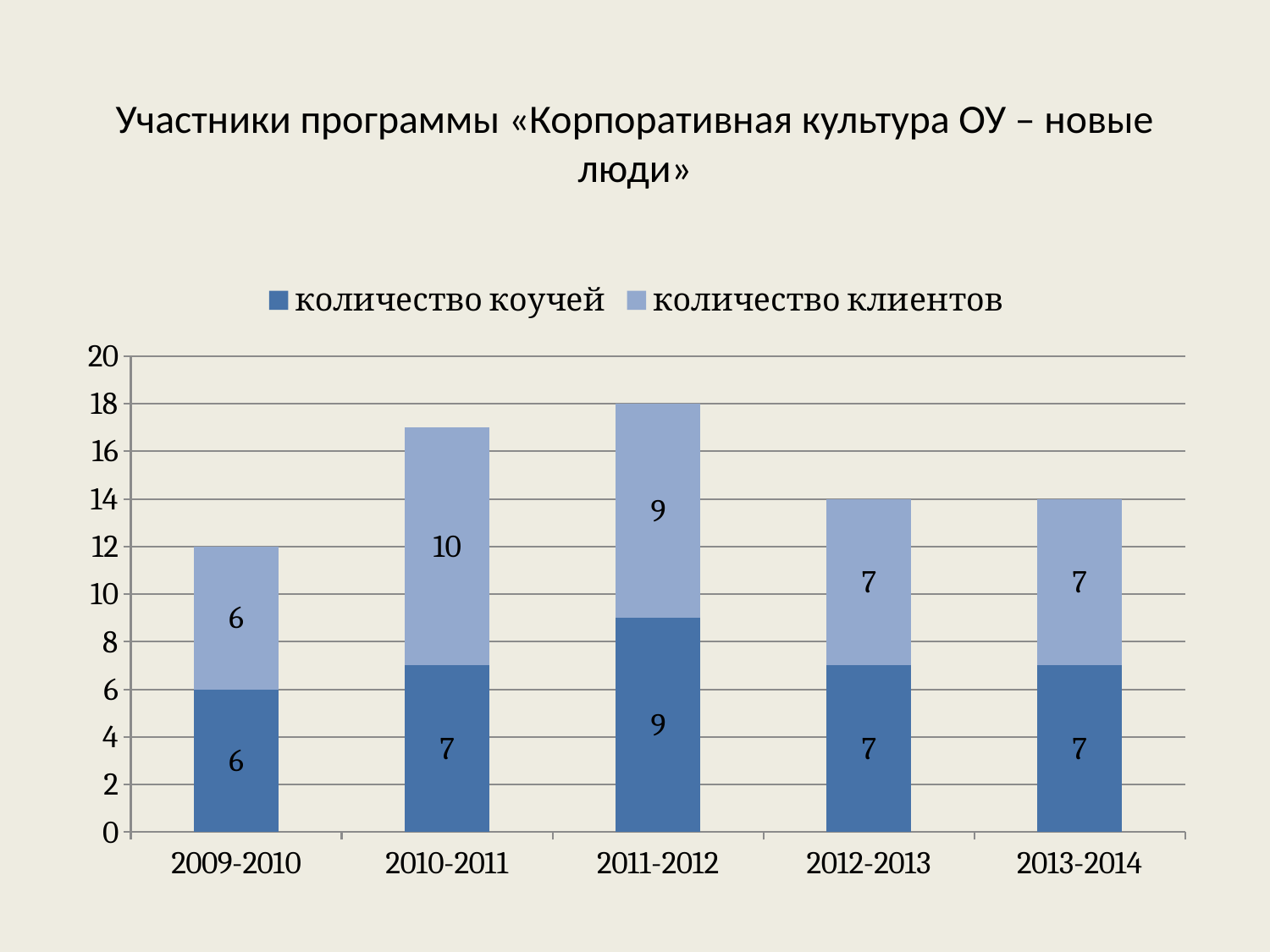
How many periods are shown on the x axis? 5 How many series does the legend list? 2 Which period has the highest value for количество клиентов? 2010-2011 What kind of chart is shown on the slide? Stacked bar chart Which is larger: количество коучей in 2011-2012 or количество коучей in 2012-2013? количество коучей in 2011-2012 Which period has the lowest value for количество коучей? 2009-2010 What is the difference between количество клиентов in 2010-2011 and in 2009-2010? 4 What is the value for количество клиентов in 2010-2011? 10 What is the total of the stacked bar for 2013-2014? 14 What is the value for количество клиентов in 2009-2010? 6 What is the total of the stacked bar for 2011-2012? 18 What is the value for количество коучей in 2011-2012? 9